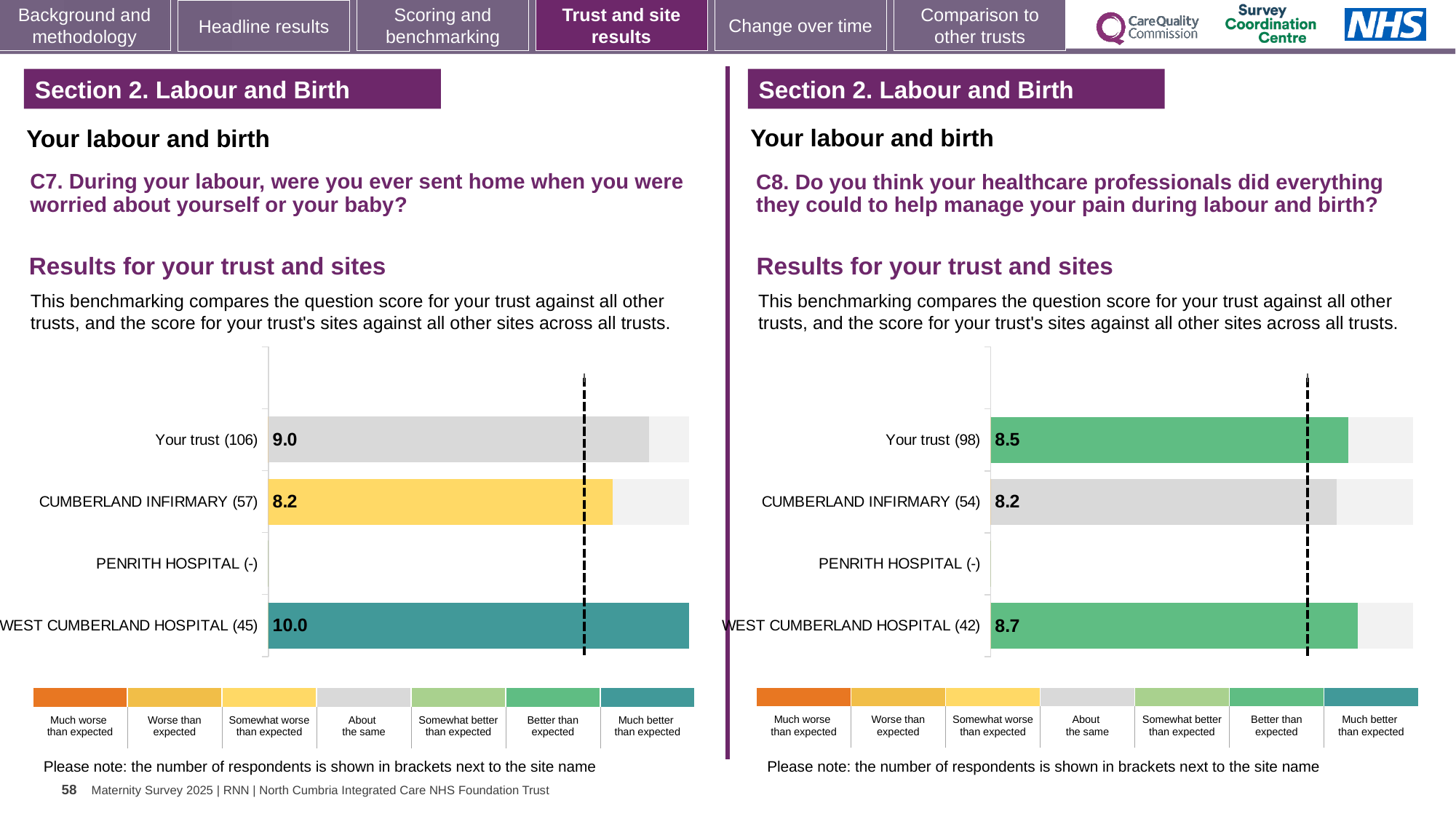
In the C8 chart on the right, which site or trust has the lowest score among those with a value shown? Cumberland Infirmary In the C7 chart on the left, what is the score for West Cumberland Hospital? 10.0 In the C8 chart on the right, what is the score for Your trust? 8.5 What kind of chart is used in the C8 chart on the right? bar chart In the C8 chart on the right, what is the score for Cumberland Infirmary? 8.2 In the C8 chart on the right, what is the difference between the scores for West Cumberland Hospital and Your trust? 0.2 In the C7 chart on the left, what is the score for Your trust? 9.0 In the C7 chart on the left, what is the difference between the scores for West Cumberland Hospital and Cumberland Infirmary? 1.8 How many categories (trust and sites) are listed in the C7 chart on the left? 4 In the C8 chart on the right, is the score for West Cumberland Hospital larger or smaller than the score for Your trust? larger In the C7 chart on the left, how many respondents are shown for Cumberland Infirmary? 57 In the C7 chart on the left, which site or trust has the highest score? West Cumberland Hospital